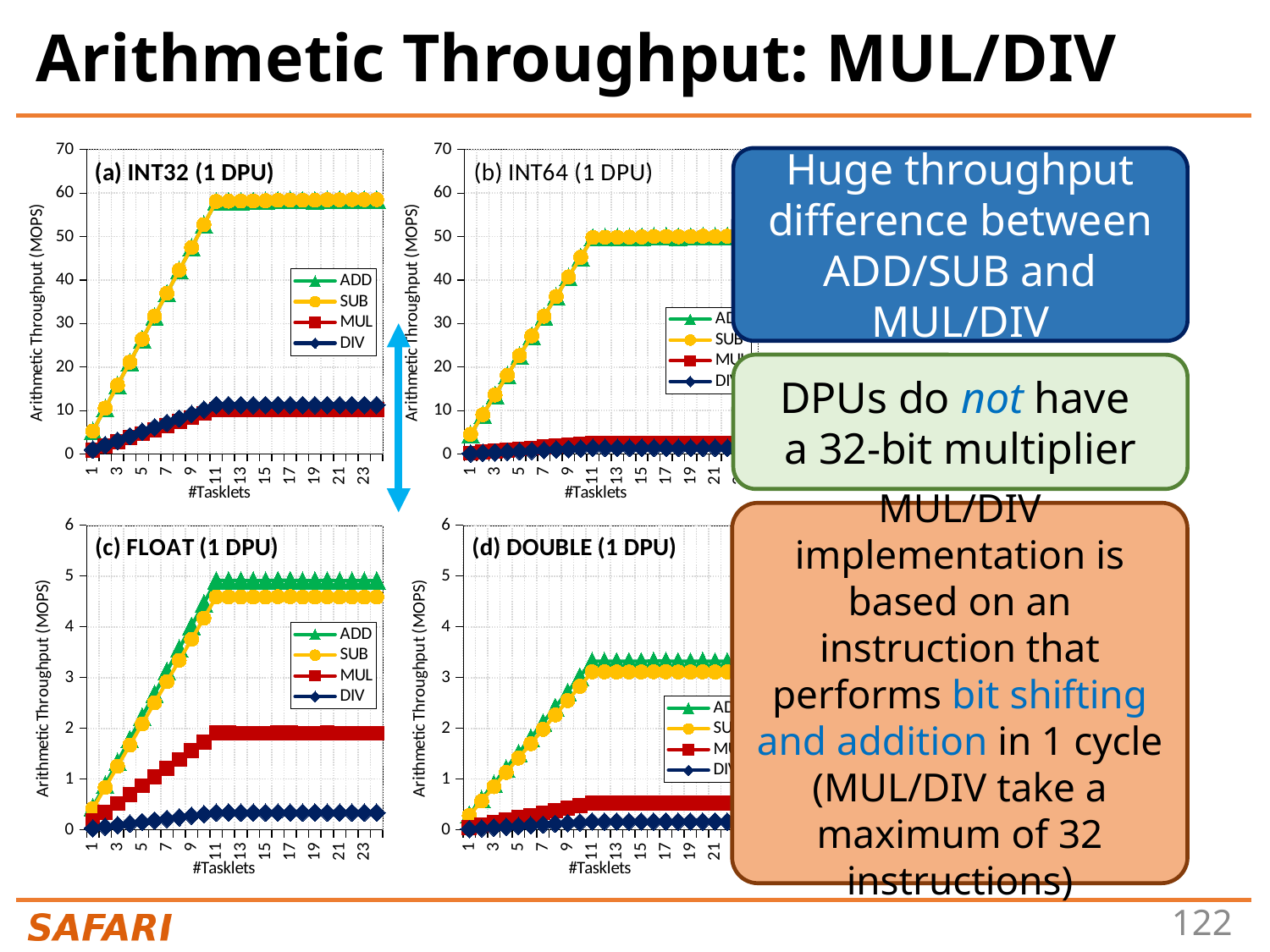
What is the y-axis label of chart (a) INT32 (1 DPU)? Arithmetic Throughput (MOPS) In chart (c) FLOAT (1 DPU), is the value for MUL at 23 tasklets greater or less than 3? less In chart (a) INT32 (1 DPU), does the ADD series rise or fall as the number of tasklets goes from 1 to 11? rise In chart (a) INT32 (1 DPU), is the value for ADD at 23 tasklets greater or less than 50? greater In chart (a) INT32 (1 DPU), at 23 tasklets, which is larger, ADD or MUL? ADD What kind of chart is chart (a) INT32 (1 DPU)? line chart In chart (a) INT32 (1 DPU), is the value for MUL at 23 tasklets greater or less than 20? less In chart (c) FLOAT (1 DPU), which series has the lowest throughput at 23 tasklets? DIV What are the legend entries in chart (c) FLOAT (1 DPU)? ADD, SUB, MUL, DIV How many series does the legend of chart (a) INT32 (1 DPU) list? 4